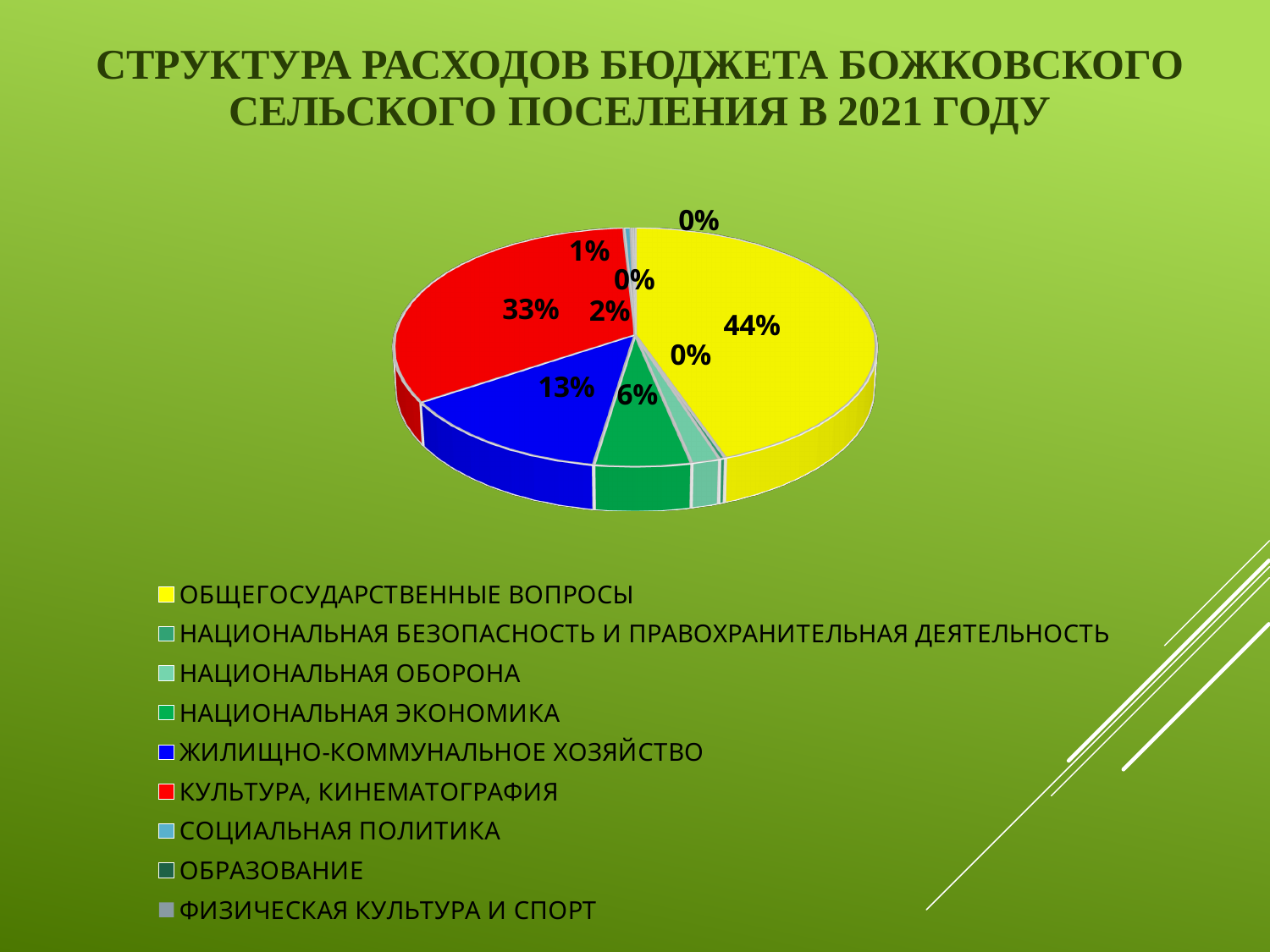
What share of the budget expenditure goes to ЖИЛИЩНО-КОММУНАЛЬНОЕ ХОЗЯЙСТВО? 13% Which colour represents КУЛЬТУРА, КИНЕМАТОГРАФИЯ in the chart? Red Which has a larger share: ЖИЛИЩНО-КОММУНАЛЬНОЕ ХОЗЯЙСТВО or НАЦИОНАЛЬНАЯ ЭКОНОМИКА? ЖИЛИЩНО-КОММУНАЛЬНОЕ ХОЗЯЙСТВО What share of the budget expenditure goes to ОБЩЕГОСУДАРСТВЕННЫЕ ВОПРОСЫ? 44% What share of the budget expenditure goes to КУЛЬТУРА, КИНЕМАТОГРАФИЯ? 33% What share of the budget expenditure goes to СОЦИАЛЬНАЯ ПОЛИТИКА? 1% What type of chart is shown on the slide? Pie chart Which expenditure category has the largest share of the budget? ОБЩЕГОСУДАРСТВЕННЫЕ ВОПРОСЫ What share of the budget expenditure goes to НАЦИОНАЛЬНАЯ ЭКОНОМИКА? 6% By how many percentage points does the share for ОБЩЕГОСУДАРСТВЕННЫЕ ВОПРОСЫ exceed the share for КУЛЬТУРА, КИНЕМАТОГРАФИЯ? 11 percentage points How many expenditure categories are listed in the chart legend? 9 What share of the budget expenditure goes to НАЦИОНАЛЬНАЯ ОБОРОНА? 2%